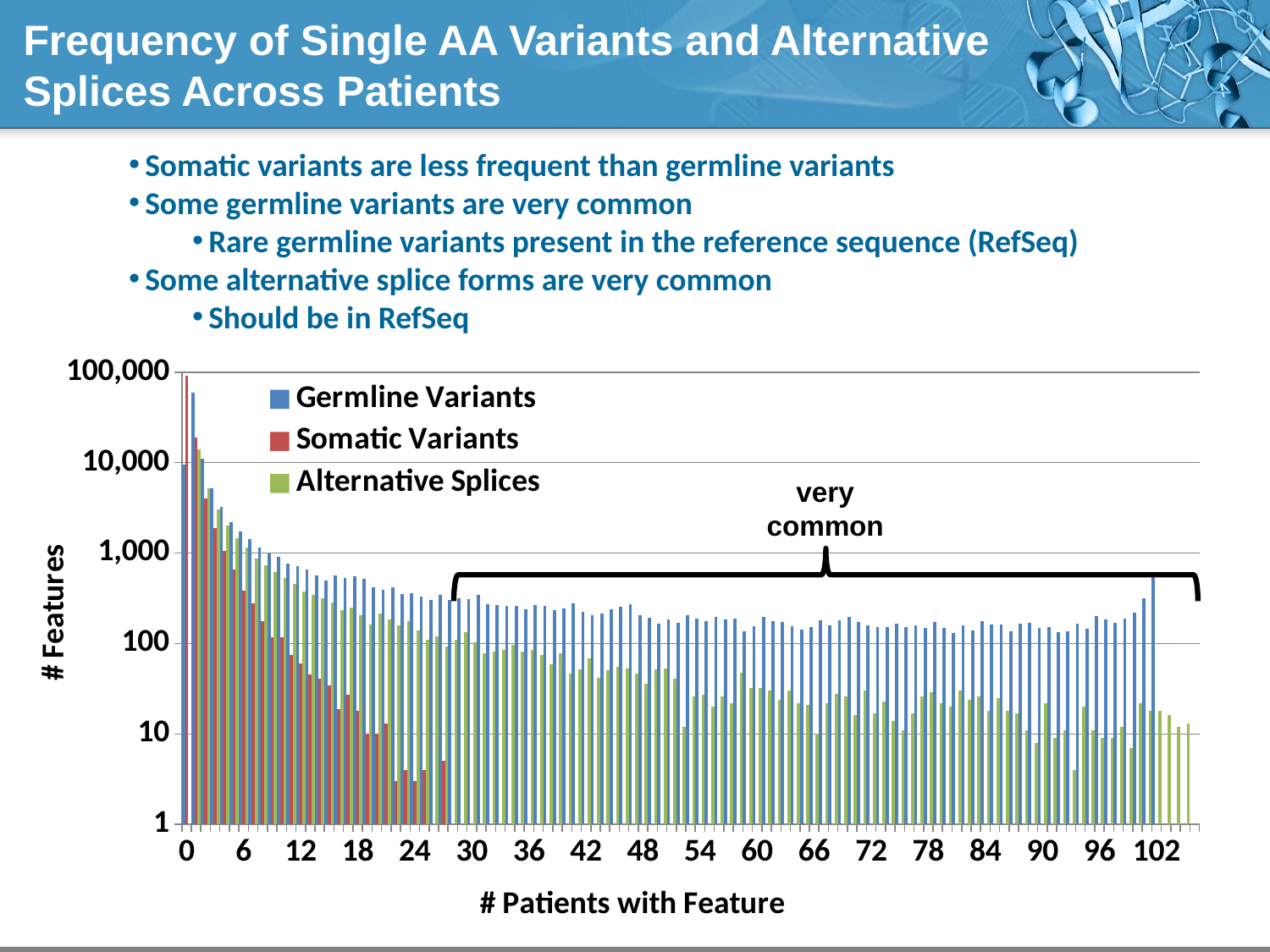
Do the Somatic Variants values generally rise or fall as the number of patients increases? fall Is the Somatic Variants value at 12 patients greater or less than 1,000? less Is the Germline Variants value at 102 patients greater or less than 100? greater Is the Somatic Variants value at 24 patients greater or less than 10? less How many series does the chart legend list? 3 What is the highest tick value shown on the y axis? 100,000 What is the label of the chart's x axis? # Patients with Feature What kind of chart is shown on the slide? Bar chart At 6 patients, which is larger: Germline Variants or Somatic Variants? Germline Variants At 18 patients, which is larger: Germline Variants or Alternative Splices? Germline Variants Which series are listed in the chart legend? Germline Variants, Somatic Variants, Alternative Splices